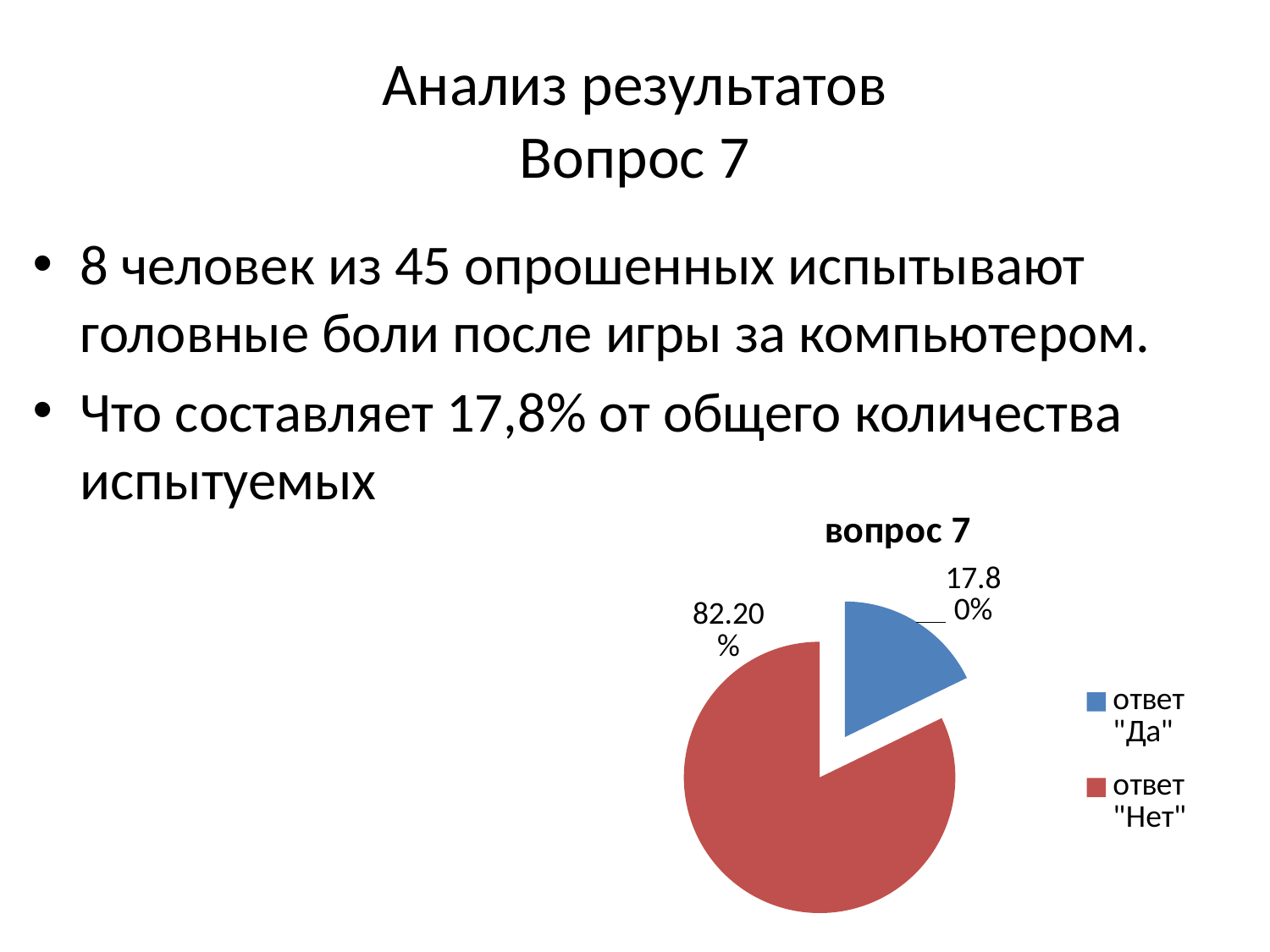
What colour is the slice for ответ "Да"? blue What kind of chart is shown on the slide? pie chart Which is larger, the share for ответ "Да" or the share for ответ "Нет"? ответ "Нет" What share of the pie is labelled for ответ "Да"? 17.80% Which slice is the smallest in the pie chart? ответ "Да" How many entries does the chart legend list? 2 What is the difference in percentage points between the ответ "Нет" slice and the ответ "Да" slice? 64.40% What share of the pie is labelled for ответ "Нет"? 82.20% What is the title of the chart? вопрос 7 Which slice is the largest in the pie chart? ответ "Нет" How many slices does the pie chart have? 2